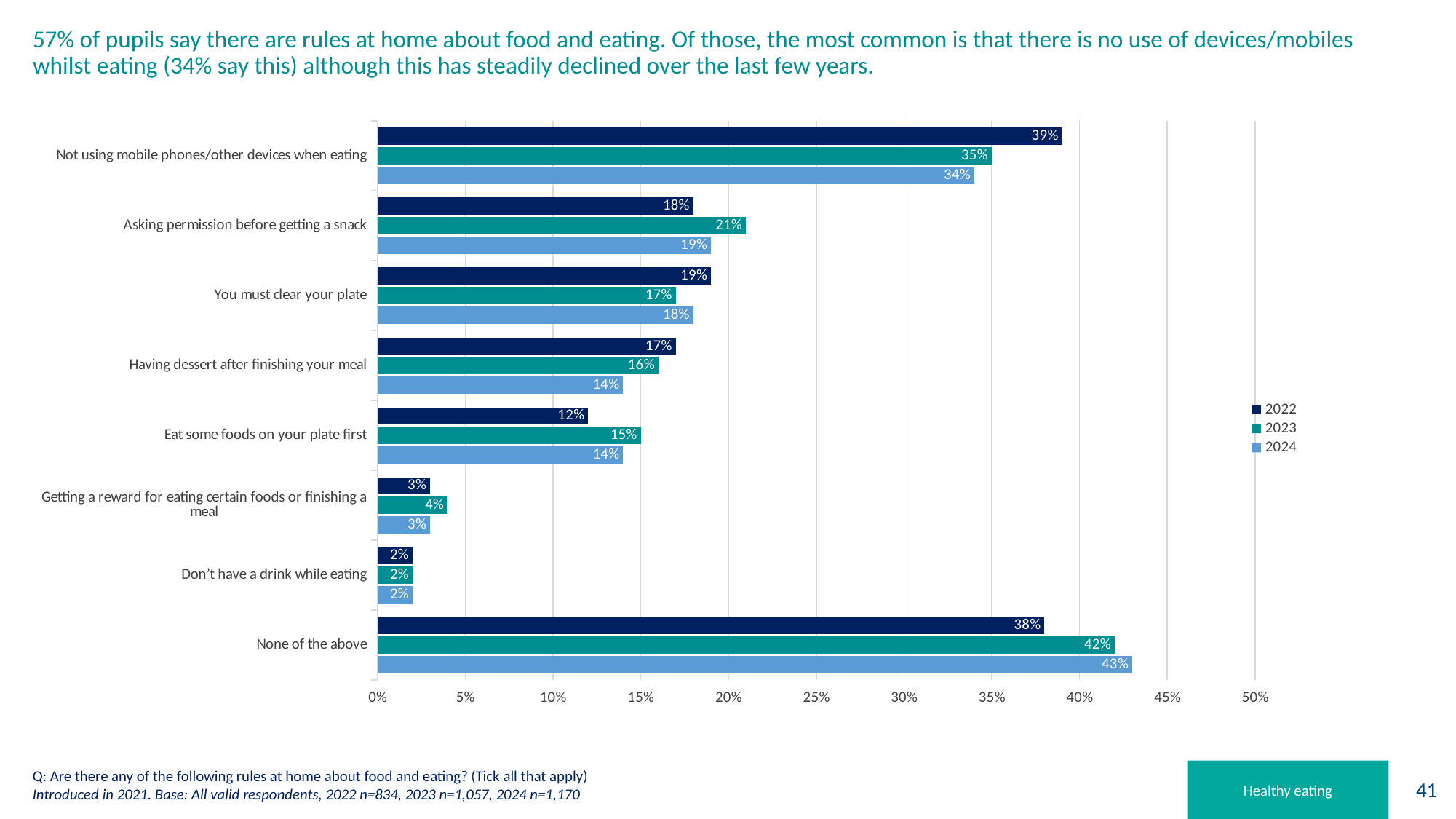
What is the 2022 value for 'None of the above'? 38% Which category has the highest value for 2024? None of the above What is the 2023 value for 'Asking permission before getting a snack'? 21% How many categories are shown on the chart? 8 What kind of chart is shown on the slide? Bar chart Which year is represented by the dark navy bars in the legend? 2022 By how many percentage points did 'Not using mobile phones/other devices when eating' fall from 2022 to 2024? 5 Did the value for 'Having dessert after finishing your meal' rise or fall from 2022 to 2024? Fall What percentage of pupils in 2024 said the rule at home was not using mobile phones/other devices when eating? 34% Which is larger for 'Eat some foods on your plate first': the 2022 value or the 2023 value? 2023 How many series does the legend list? 3 Which category has the lowest value for 2022? Don't have a drink while eating